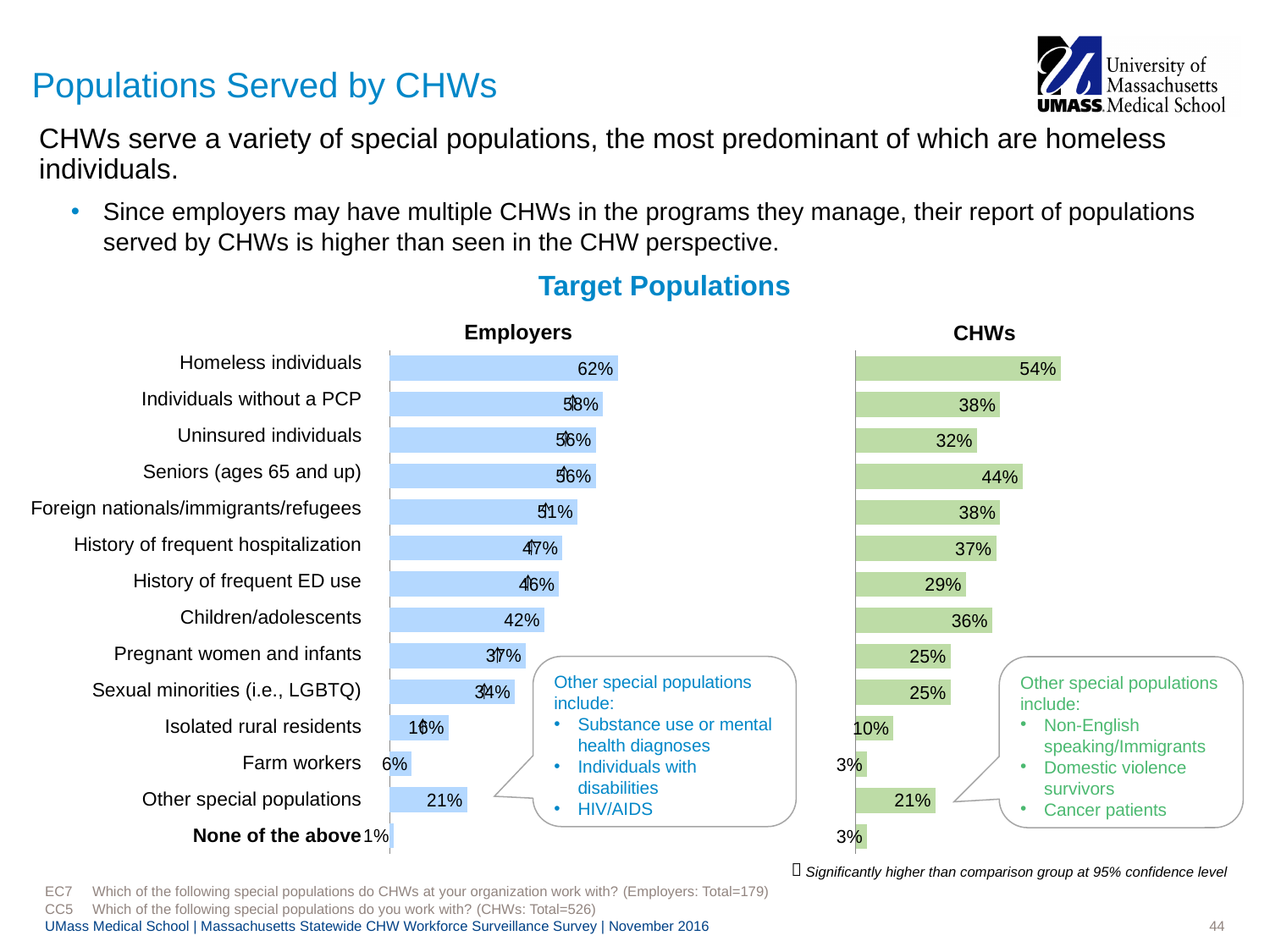
In the Employers chart, which category has the lowest percentage? None of the above In the CHWs chart, what percentage is shown for Homeless individuals? 54% In the Employers chart, what percentage is shown for Homeless individuals? 62% In the Employers chart, what percentage is shown for Other special populations? 21% How many categories are listed in the Employers chart? 14 In the CHWs chart, which is larger: Seniors (ages 65 and up) or Uninsured individuals? Seniors (ages 65 and up) In the CHWs chart, which population has the highest percentage? Homeless individuals What type of chart is used to show the Target Populations data? Bar chart In the CHWs chart, what percentage is shown for Children/adolescents? 36% What is the title shown above the two charts? Target Populations In the CHWs chart, what percentage is shown for Seniors (ages 65 and up)? 44% What is the difference in percentage points between the Employers and CHWs values for Homeless individuals? 8 percentage points